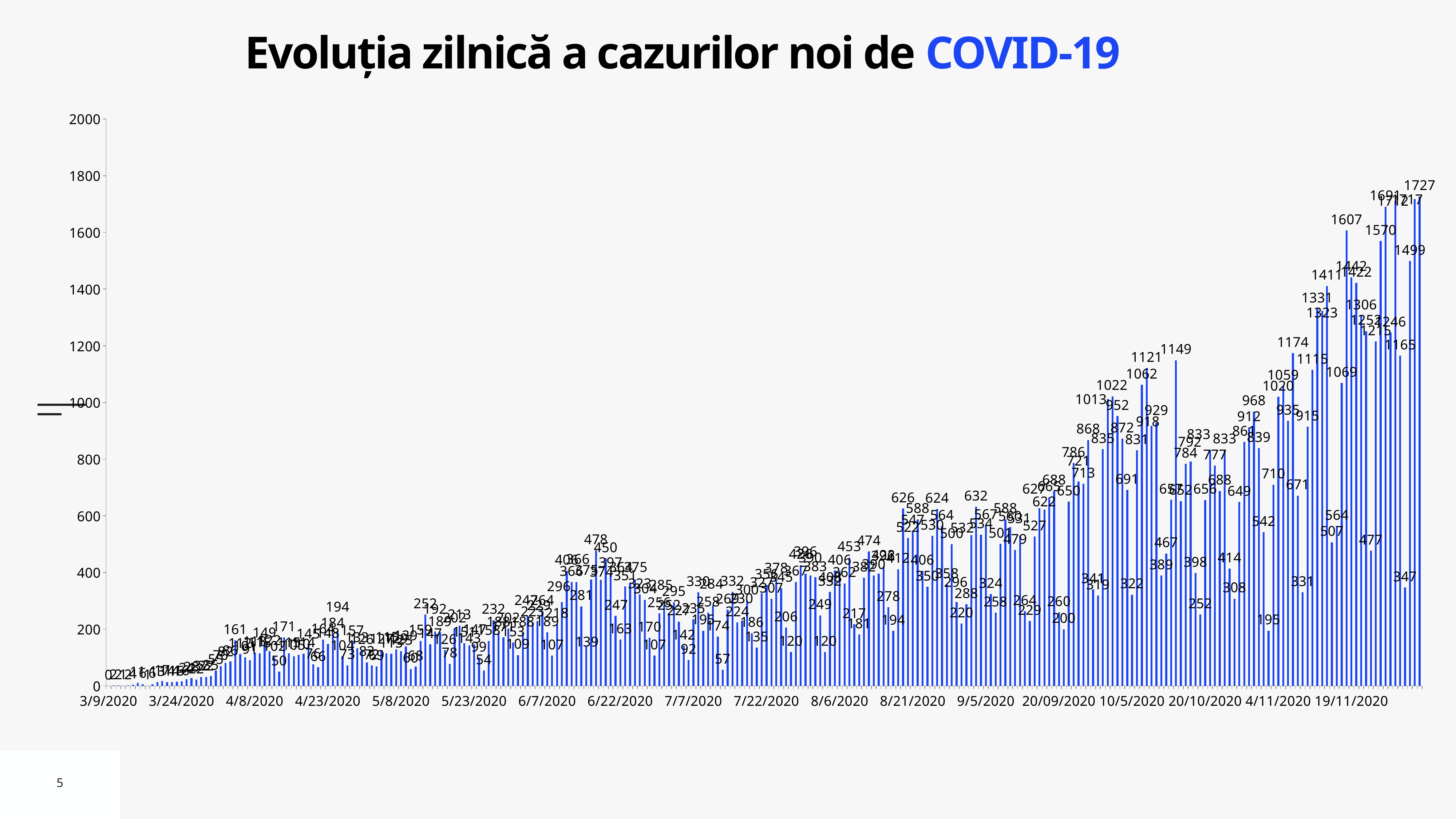
Are the bars near the left end of the chart (March 2020) greater or less than 200? less What is the first date label shown on the x axis? 3/9/2020 What is the last date label shown on the x axis? 19/11/2020 What kind of chart is shown on the slide? Bar chart Do the daily case values overall rise or fall from left to right along the x axis? Rise How many date labels are shown on the x axis? 18 Is the highest bar on the chart greater or less than 1800? less What is the maximum value shown on the y axis? 2000 What is the title of the chart? Evoluția zilnică a cazurilor noi de COVID-19 What is the highest daily value labeled on the chart? 1727 Is the highest bar on the chart greater or less than 1600? greater Which is larger: the highest bar at the right end of the chart or the highest bar around 6/22/2020? The highest bar at the right end